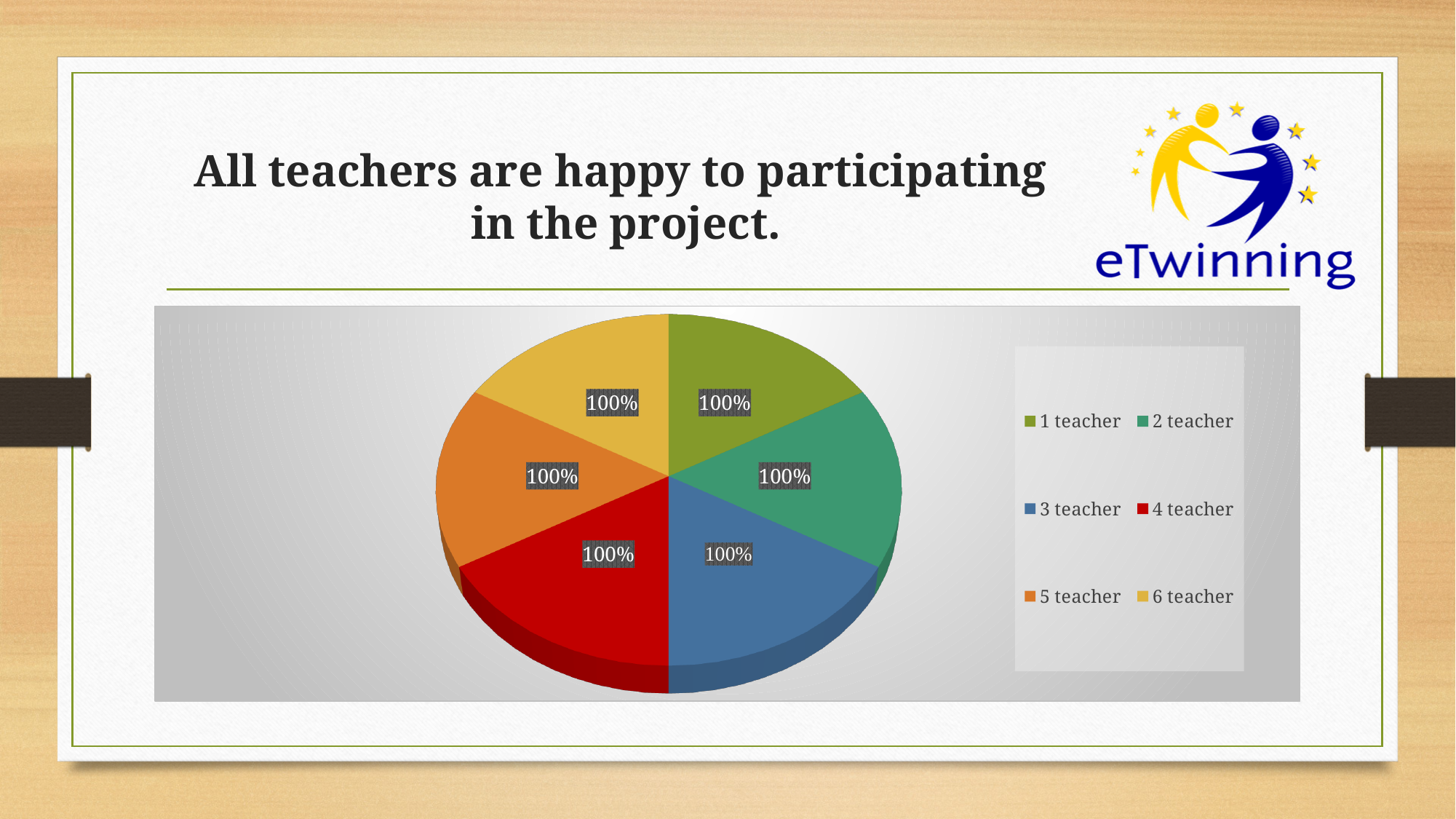
What value is labelled on the slice for 6 teacher? 100% What kind of chart is shown on the slide? pie chart What colour is the slice for 4 teacher in the pie chart? red What value is labelled on the slice for 1 teacher? 100% How many slices does the pie chart have? 6 Which legend entry is shown in green (the first entry)? 1 teacher What value is labelled on the slice for 3 teacher? 100% Are all the slices of the pie chart labelled with the same value? yes What value is labelled on the slice for 4 teacher? 100% How many entries does the legend of the pie chart list? 6